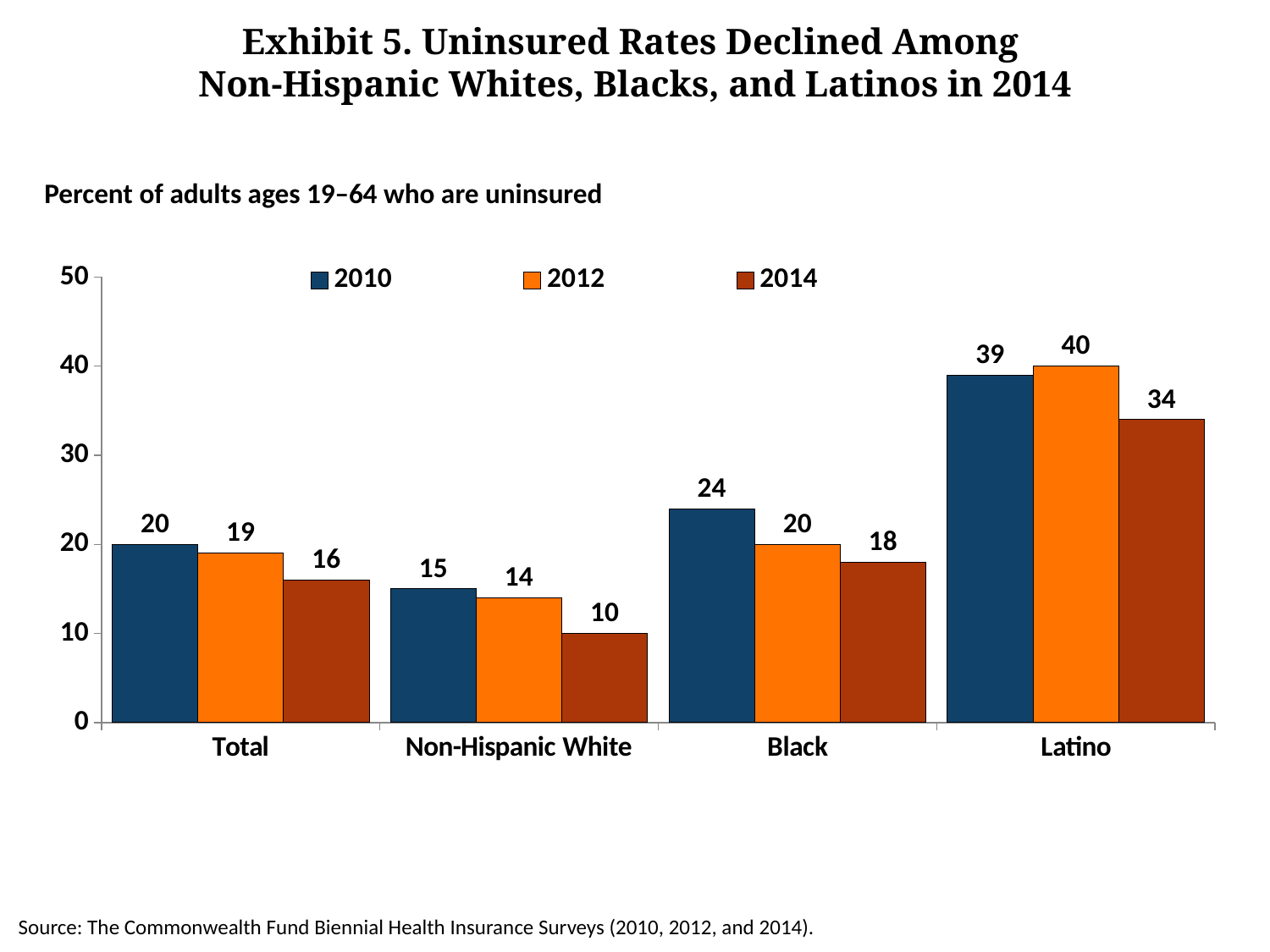
Which is larger: the 2012 value for Latino adults or the 2010 value for Latino adults? 2012 Which year does the dark blue series represent? 2010 How many categories are shown on the x axis? 4 Is the 2014 value for Total greater or less than 20? less Which category has the highest uninsured rate in 2014? Latino What is the value for Black adults in 2010? 24 What is the value for Non-Hispanic White adults in 2012? 14 What kind of chart is shown on the slide? bar chart What is the difference between the 2010 and 2014 values for Black adults? 6 How many series does the legend list? 3 What is the uninsured rate for Latino adults in 2014? 34 Which category has the lowest uninsured rate in 2014? Non-Hispanic White